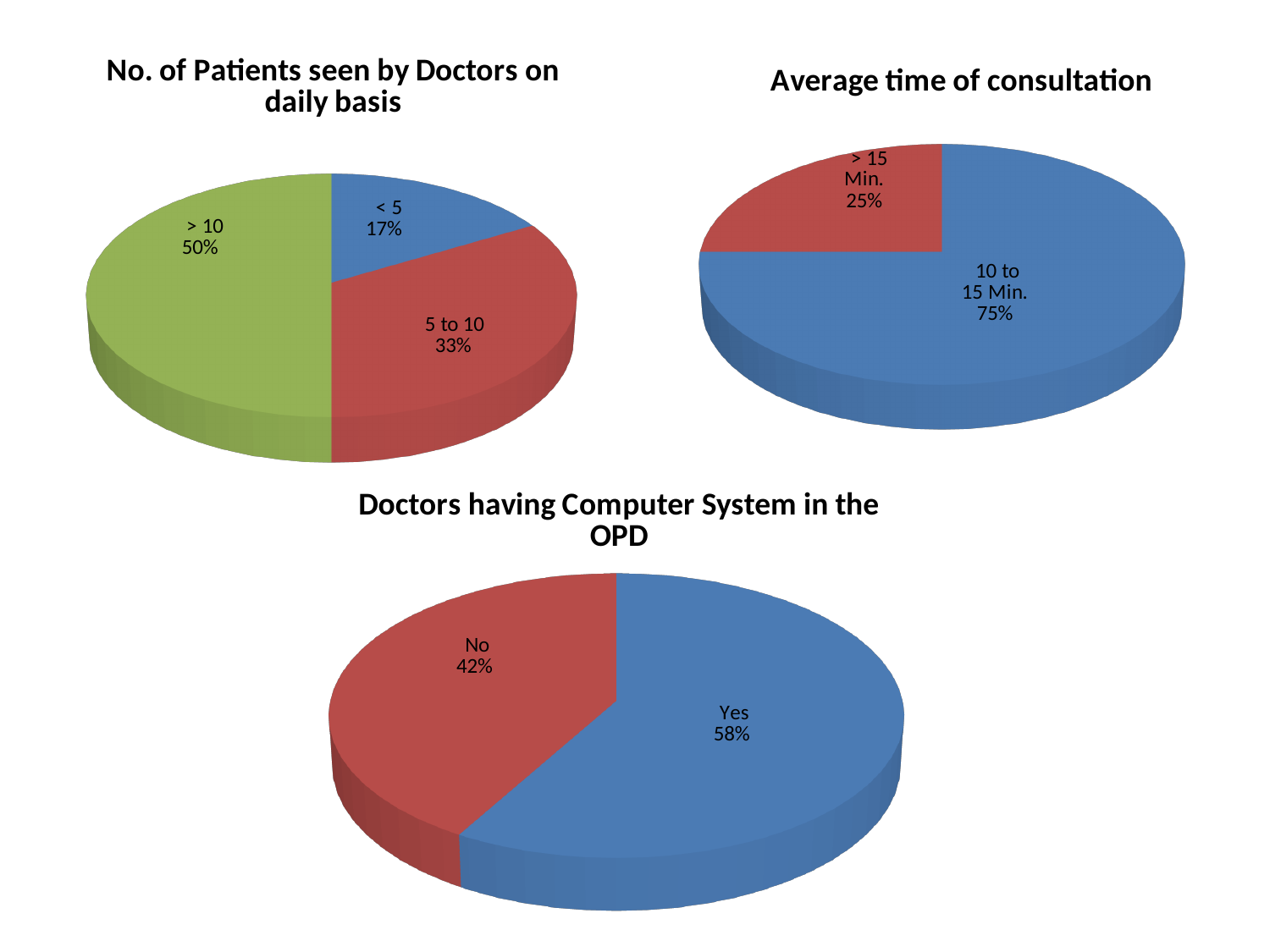
In the 'No. of Patients seen by Doctors on daily basis' chart, what is the difference between the '> 10' and '< 5' shares? 33% In the 'Doctors having Computer System in the OPD' chart, which is larger, 'Yes' or 'No'? Yes In the 'No. of Patients seen by Doctors on daily basis' chart, how many slices does the pie have? 3 In the 'No. of Patients seen by Doctors on daily basis' chart, what percentage is shown for '5 to 10'? 33% In the 'Average time of consultation' chart, what percentage is shown for '10 to 15 Min.'? 75% In the 'Average time of consultation' chart, which category has the largest share? 10 to 15 Min. In the 'No. of Patients seen by Doctors on daily basis' chart, what share of the pie is the '> 10' slice? 50% How many charts are shown on the slide? 3 What type of chart is the 'Doctors having Computer System in the OPD' chart? Pie chart In the 'Average time of consultation' chart, what is the difference between the '10 to 15 Min.' and '> 15 Min.' shares? 50% In the 'Doctors having Computer System in the OPD' chart, what percentage is shown for 'No'? 42% In the 'No. of Patients seen by Doctors on daily basis' chart, which category has the smallest share? < 5